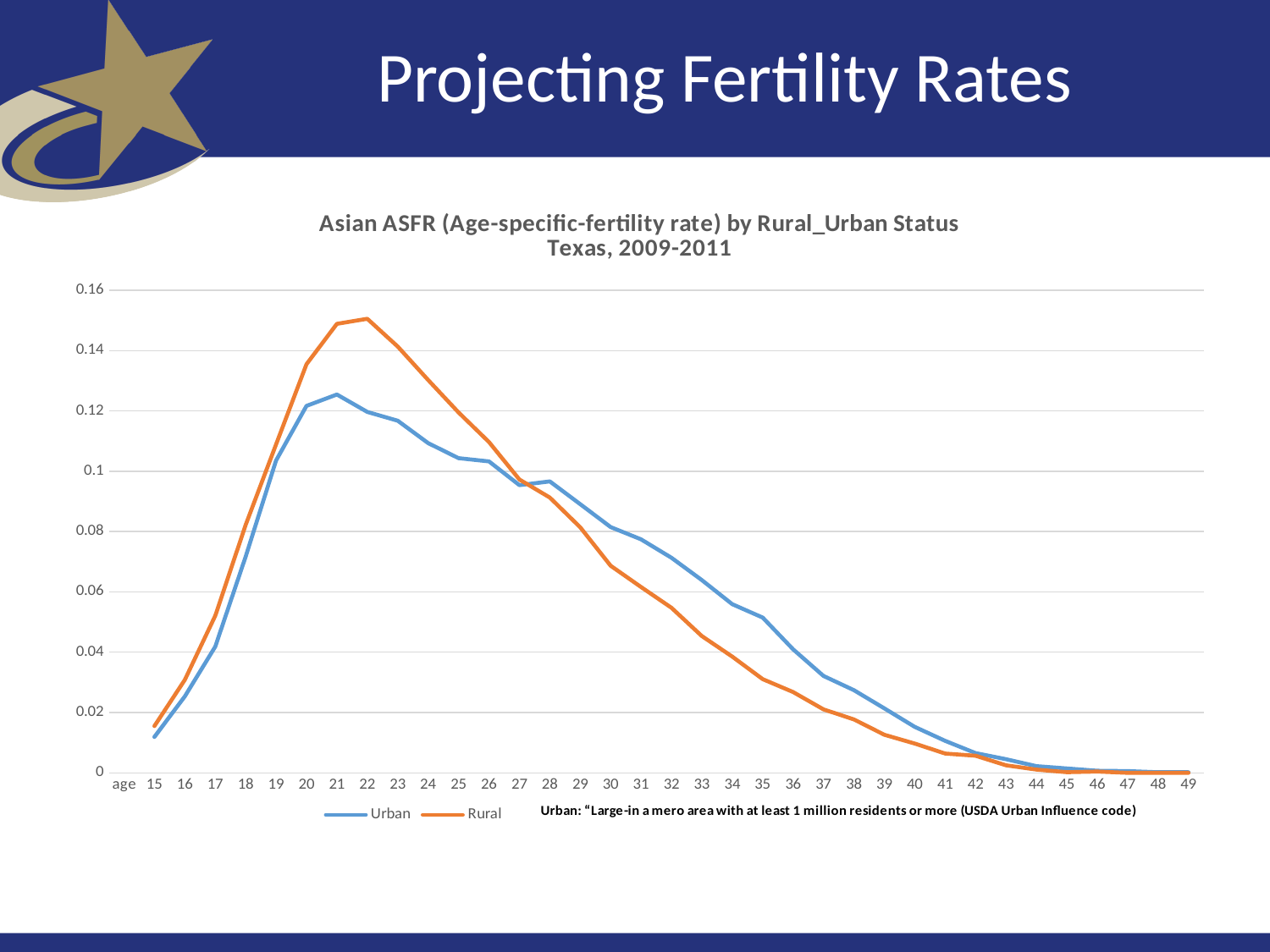
Which two series are shown in the legend? Urban and Rural How many ages are plotted along the x axis? 35 Is the Rural value at age 30 greater or less than 0.08? less What is the title of the chart? Asian ASFR (Age-specific-fertility rate) by Rural_Urban Status Texas, 2009-2011 At age 35, which series has the larger value, Urban or Rural? Urban Is the Urban value at age 40 greater or less than 0.02? less At which age does the Rural series reach its highest value? 22 How many series does the legend list? 2 Is the Rural value at age 22 greater or less than 0.14? greater At which age does the Urban series reach its highest value? 21 What kind of chart is shown on the slide? Line chart Do the Rural values rise or fall from age 22 to age 49? Fall